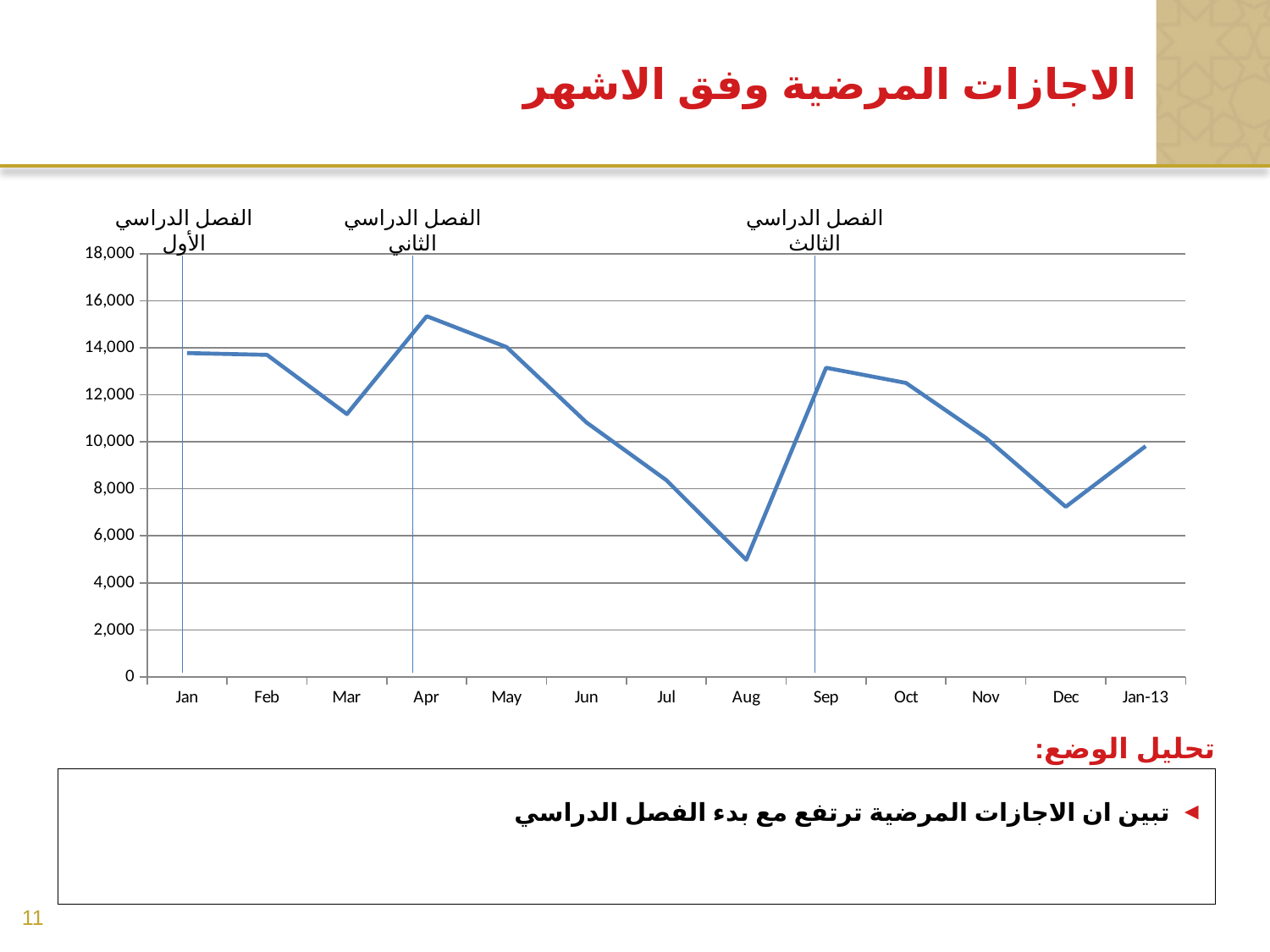
How many months are plotted along the x axis? 13 How many vertical marker lines labelled with semester names are drawn on the chart? 3 Is the value for Aug greater or less than 6,000? less What kind of chart is shown on the slide? line chart Is the value for Dec greater or less than 8,000? less Is the value for Apr greater or less than 14,000? greater Which is larger, the value for Apr or the value for Sep? Apr Which month has the highest value on the chart? Apr Which is larger, the value for Aug or the value for Dec? Dec Do the values rise or fall from May to Aug? fall Which month has the lowest value on the chart? Aug